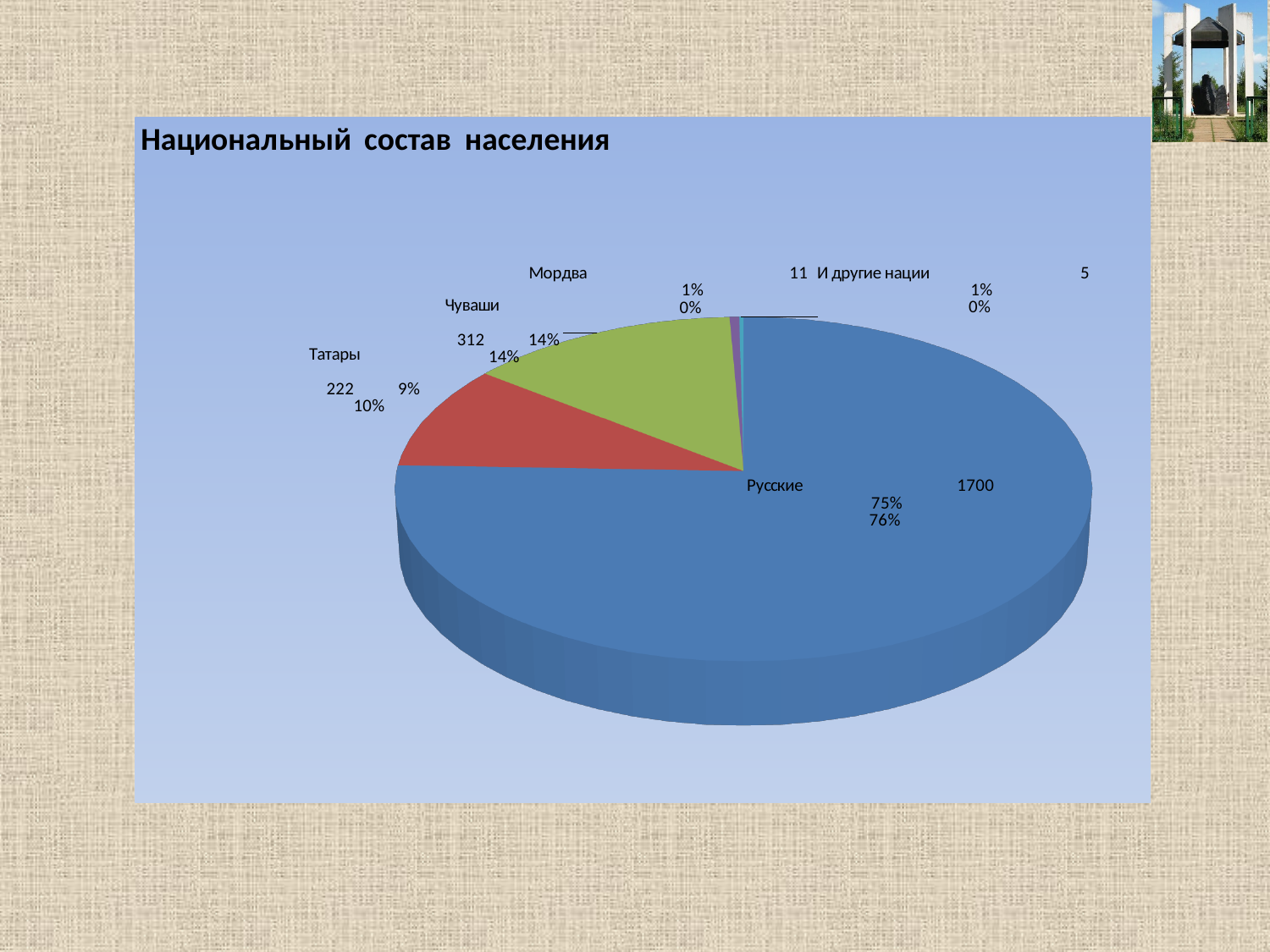
What is the difference between the values for Чуваши and Татары? 90 Which category has the smallest value? И другие нации What is the value shown for И другие нации? 5 What is the difference between the values for Русские and Чуваши? 1388 Which category has the largest slice of the pie? Русские What is the value shown for Русские? 1700 What type of chart is shown on the slide? Pie chart Which is larger, the value for Чуваши or the value for Татары? Чуваши How many categories are shown in the pie chart? 5 What is the value shown for Татары? 222 What is the value shown for Чуваши? 312 What is the value shown for Мордва? 11